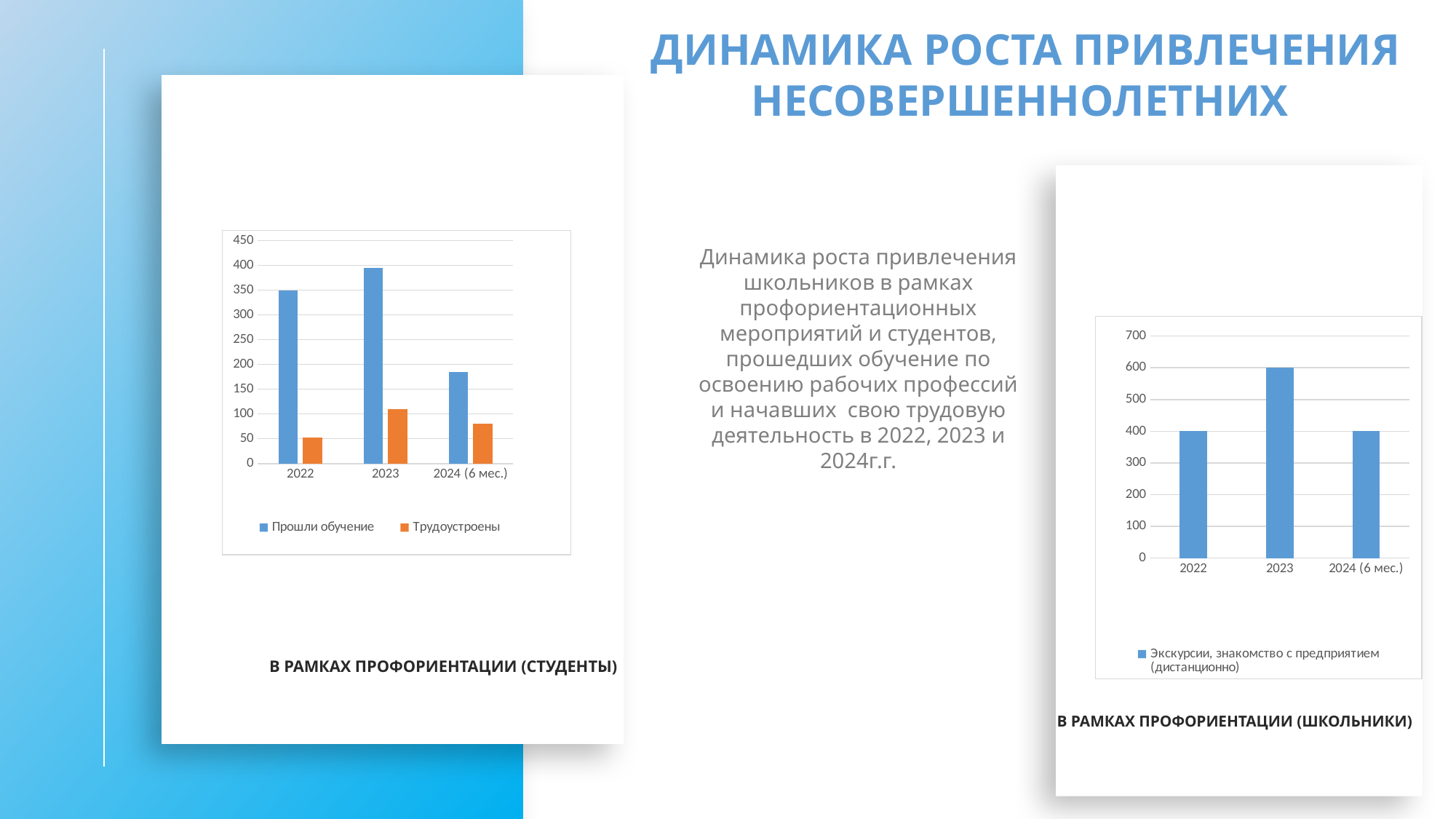
In the chart "В РАМКАХ ПРОФОРИЕНТАЦИИ (ШКОЛЬНИКИ)", which year has the highest value? 2023 In the chart "В РАМКАХ ПРОФОРИЕНТАЦИИ (СТУДЕНТЫ)", is the value for "Прошли обучение" in 2024 (6 мес.) greater or less than 200? less In the chart "В РАМКАХ ПРОФОРИЕНТАЦИИ (СТУДЕНТЫ)", is the value for "Трудоустроены" in 2023 greater or less than 100? greater In the chart "В РАМКАХ ПРОФОРИЕНТАЦИИ (СТУДЕНТЫ)", which year has the highest value for "Прошли обучение"? 2023 In the chart "В РАМКАХ ПРОФОРИЕНТАЦИИ (ШКОЛЬНИКИ)", what is the value for 2022? 400 In the chart "В РАМКАХ ПРОФОРИЕНТАЦИИ (СТУДЕНТЫ)", which year has the larger value for "Трудоустроены": 2023 or 2024 (6 мес.)? 2023 How many series does the legend of the chart "В РАМКАХ ПРОФОРИЕНТАЦИИ (СТУДЕНТЫ)" list? 2 What kind of chart is the chart titled "В РАМКАХ ПРОФОРИЕНТАЦИИ (ШКОЛЬНИКИ)" on the right? Bar chart In the chart "В РАМКАХ ПРОФОРИЕНТАЦИИ (ШКОЛЬНИКИ)", what is the difference between the values for 2023 and 2022? 200 In the chart "В РАМКАХ ПРОФОРИЕНТАЦИИ (ШКОЛЬНИКИ)", what is the value for 2023? 600 How many categories are shown on the x axis of the chart "В РАМКАХ ПРОФОРИЕНТАЦИИ (ШКОЛЬНИКИ)"? 3 In the chart "В РАМКАХ ПРОФОРИЕНТАЦИИ (СТУДЕНТЫ)", which series is shown in orange? Трудоустроены